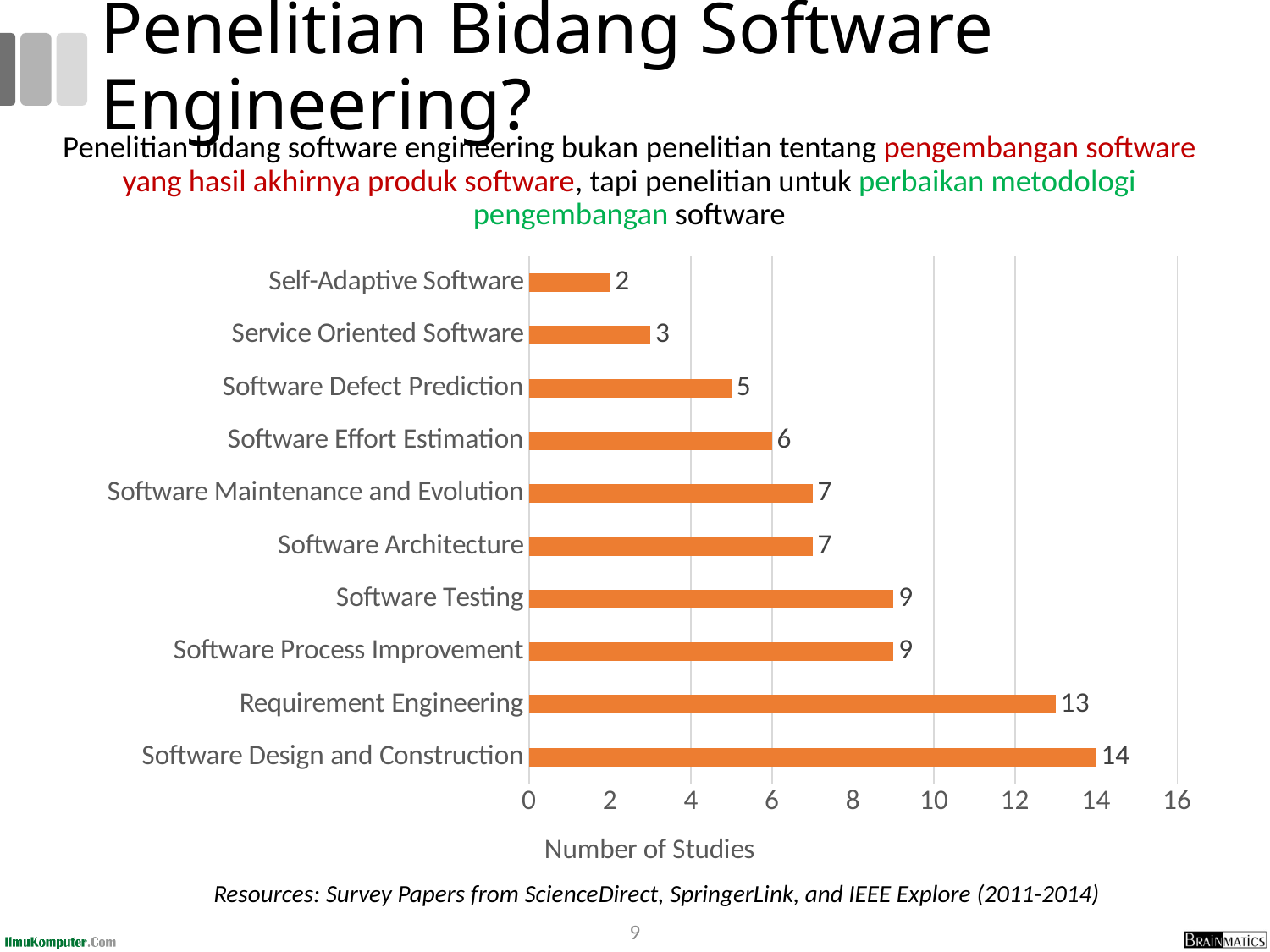
What is the difference in number of studies between Software Design and Construction and Requirement Engineering? 1 What is the number of studies for Software Testing? 9 What kind of chart is shown on the slide? Bar chart What is the number of studies for Requirement Engineering? 13 What is the label of the horizontal axis of the chart? Number of Studies What is the difference in number of studies between Software Testing and Service Oriented Software? 6 Is the value for Software Process Improvement greater or less than 8? greater Which has more studies, Software Effort Estimation or Software Architecture? Software Architecture What is the number of studies for Software Defect Prediction? 5 Which category has the lowest number of studies? Self-Adaptive Software How many categories are shown in the chart? 10 Which category has the highest number of studies? Software Design and Construction